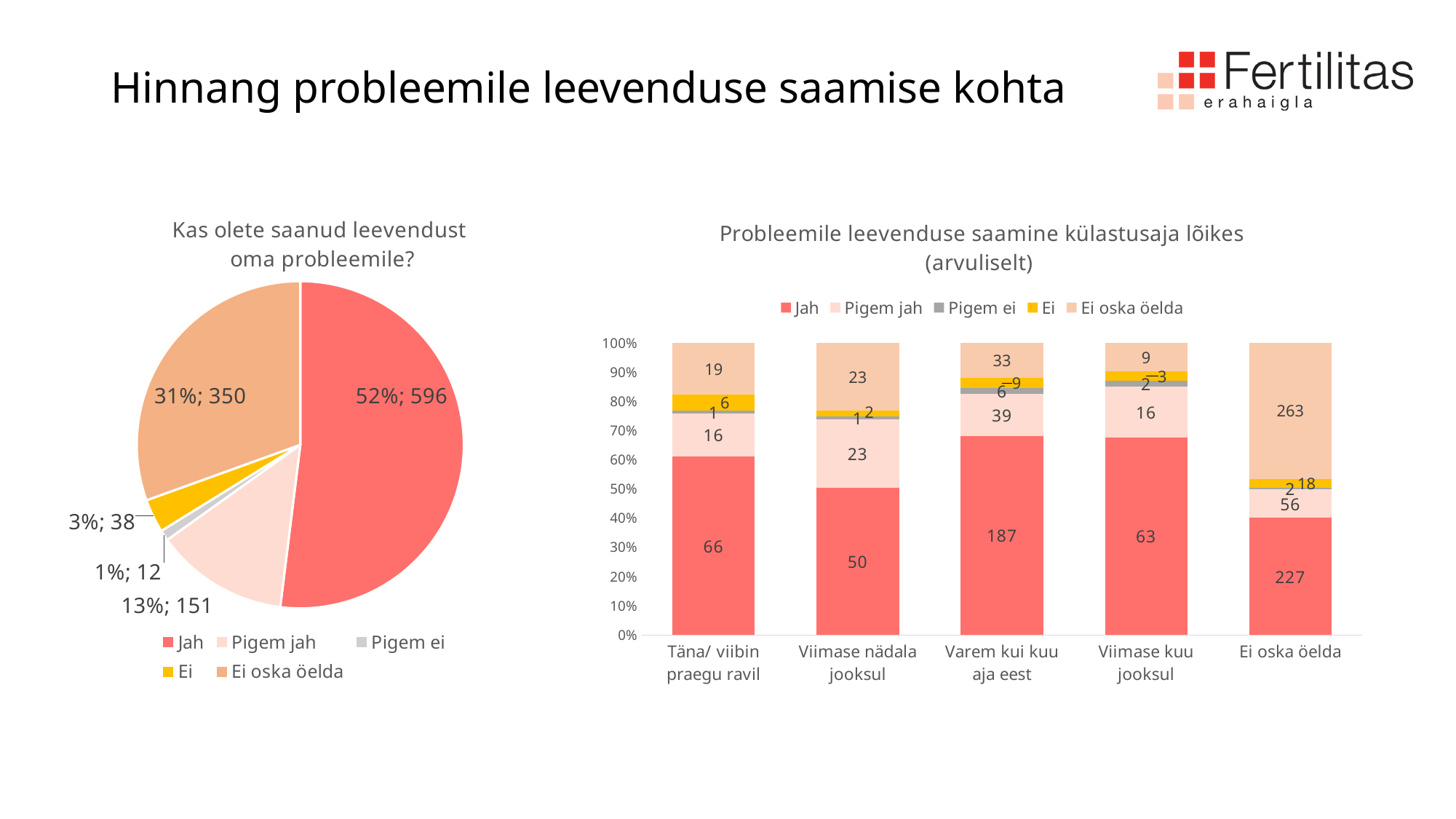
In the pie chart "Kas olete saanud leevendust oma probleemile?", how many responses are "Ei oska öelda"? 350 In the chart "Probleemile leevenduse saamine külastusaja lõikes (arvuliselt)", what is the "Ei oska öelda" value for the "Ei oska öelda" category? 263 What kind of chart is the right chart, "Probleemile leevenduse saamine külastusaja lõikes (arvuliselt)"? Stacked bar chart How many categories are shown on the x axis of the chart "Probleemile leevenduse saamine külastusaja lõikes (arvuliselt)"? 5 In the chart "Probleemile leevenduse saamine külastusaja lõikes (arvuliselt)", which has the larger "Pigem jah" value: "Viimase nädala jooksul" or "Täna/ viibin praegu ravil"? Viimase nädala jooksul In the chart "Probleemile leevenduse saamine külastusaja lõikes (arvuliselt)", what is the total of all segments in the "Viimase kuu jooksul" bar? 93 In the pie chart "Kas olete saanud leevendust oma probleemile?", which category has the smallest slice? Pigem ei In the chart "Probleemile leevenduse saamine külastusaja lõikes (arvuliselt)", what is the "Jah" value for "Varem kui kuu aja eest"? 187 How many series does the legend of the chart "Probleemile leevenduse saamine külastusaja lõikes (arvuliselt)" list? 5 What kind of chart is the left chart, "Kas olete saanud leevendust oma probleemile?"? Pie chart In the pie chart "Kas olete saanud leevendust oma probleemile?", what share of responses is "Jah"? 52% In the chart "Probleemile leevenduse saamine külastusaja lõikes (arvuliselt)", what is the difference between the "Jah" values for "Ei oska öelda" and "Varem kui kuu aja eest"? 40